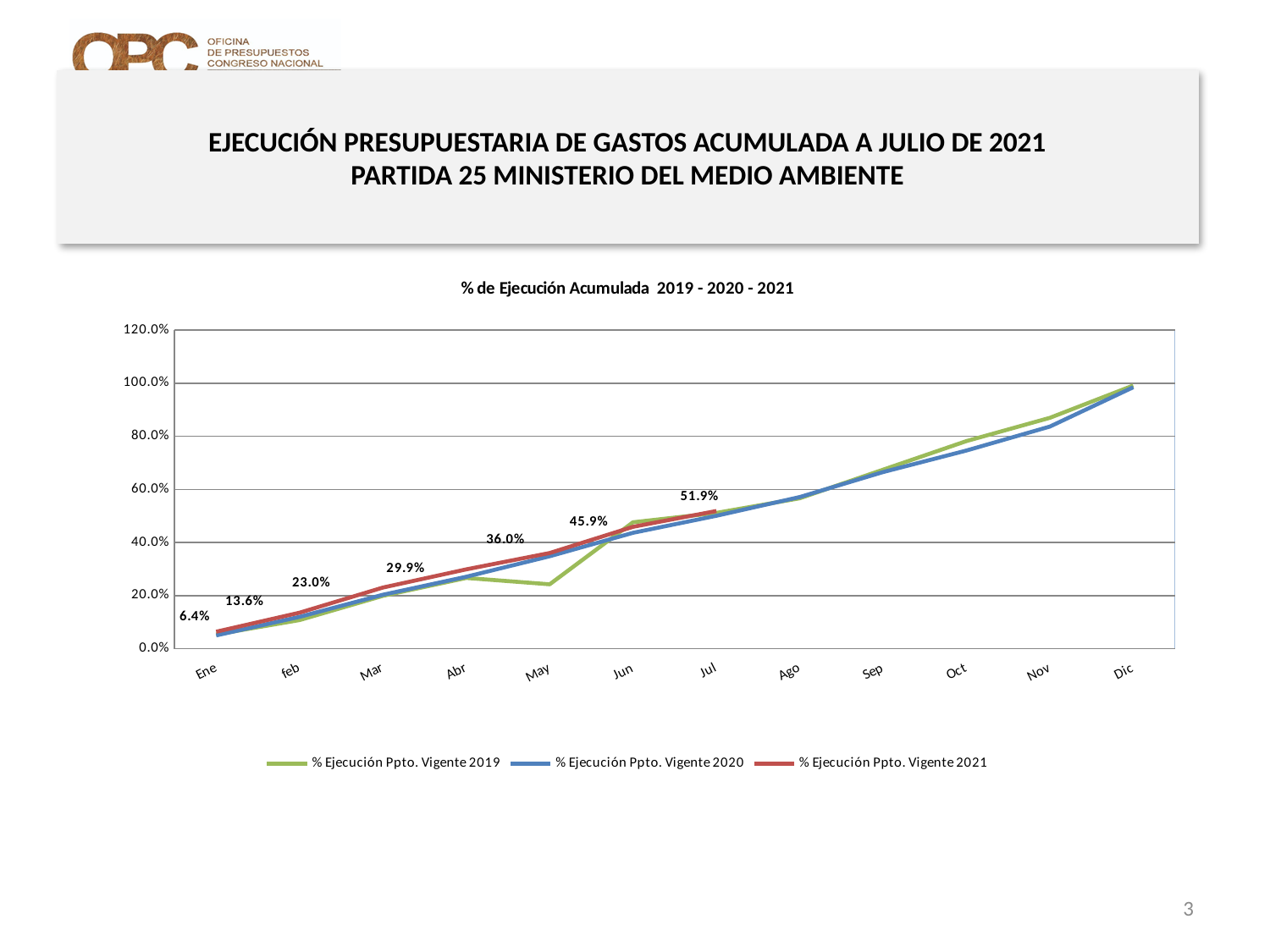
How many months are shown on the x axis? 12 In which month does the % Ejecución Ppto. Vigente 2021 series reach its highest value? Jul Does the % Ejecución Ppto. Vigente 2021 series rise or fall from Ene to Jul? Rise What kind of chart is shown on the slide? Line chart How many series does the legend list? 3 What is the value of % Ejecución Ppto. Vigente 2021 in Ene? 6.4% In May, which series has the larger value: % Ejecución Ppto. Vigente 2019 or % Ejecución Ppto. Vigente 2020? % Ejecución Ppto. Vigente 2020 What is the value of % Ejecución Ppto. Vigente 2021 in Jul? 51.9% What is the difference between the 2021 values for Jul and Jun? 6.0% What is the value of % Ejecución Ppto. Vigente 2021 in May? 36.0% Is the value for % Ejecución Ppto. Vigente 2019 in May greater or less than 40.0%? less What is the difference between the 2021 values for Mar and feb? 9.4%